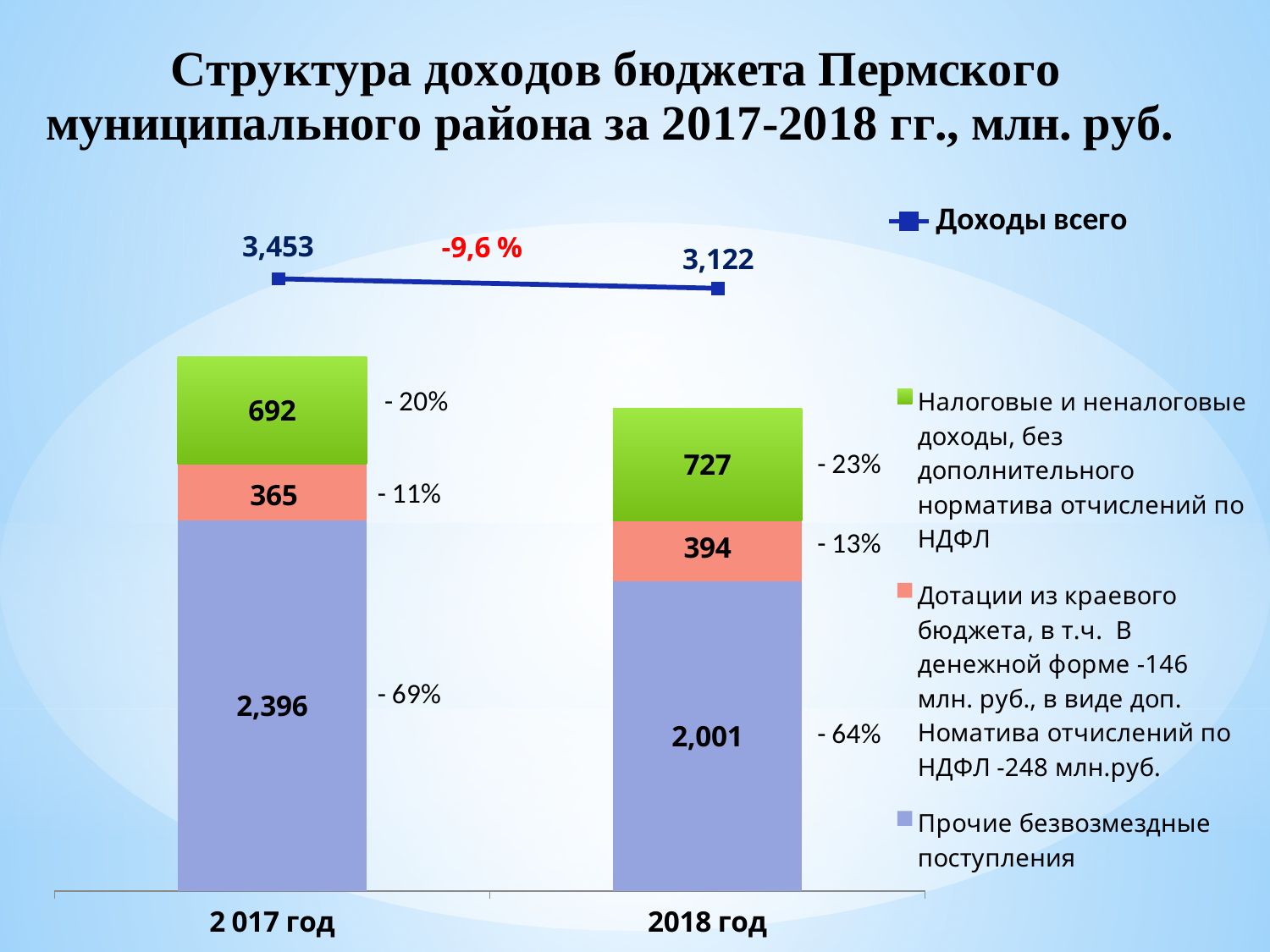
What is the total 'Доходы всего' for 2017 год? 3,453 What is the value of 'Дотации из краевого бюджета' for 2018 год? 394 What is the value of 'Налоговые и неналоговые доходы' for 2018 год? 727 What is the value of 'Прочие безвозмездные поступления' for 2017 год? 2,396 What is the difference between 'Налоговые и неналоговые доходы' in 2018 год and 2017 год? 35 What is the total 'Доходы всего' for 2018 год? 3,122 Which year has the larger value for 'Прочие безвозмездные поступления'? 2 017 год What percentage change in total income is shown between 2017 and 2018? -9,6 % Which segment is the smallest in the 2017 год bar? Дотации из краевого бюджета (365) How many year categories are shown on the x axis? 2 What kind of chart is this? Stacked bar chart with a line What share of the 2018 год bar does 'Прочие безвозмездные поступления' represent, according to the label? 64%